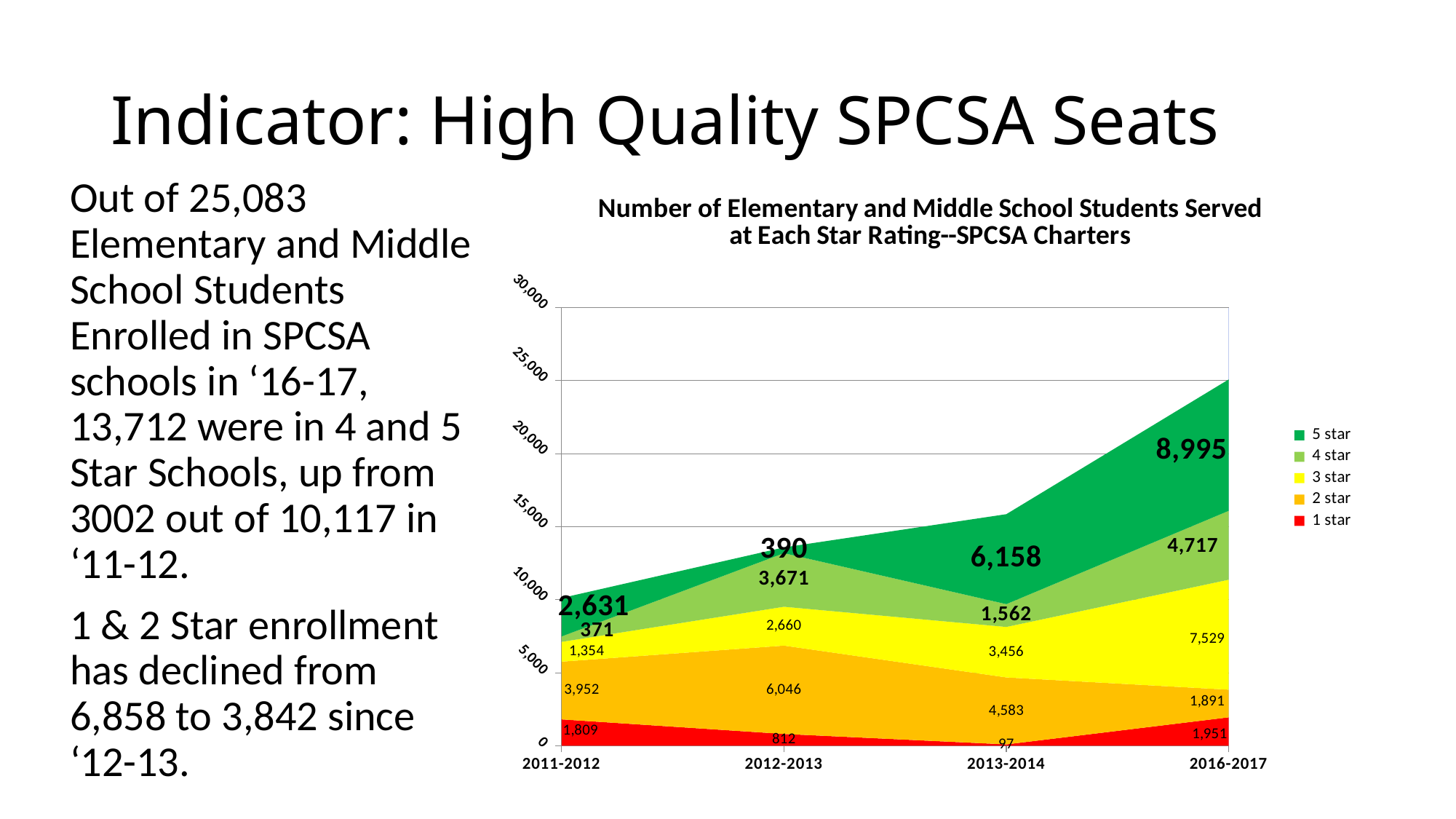
In which school year was the 5 star value highest? 2016-2017 What is the total number of students served across all star ratings in 2016-2017? 25,083 How many school years are shown on the x axis? 4 How many 1 star students were served in 2013-2014? 97 How many 2 star students were served in 2012-2013? 6,046 Which is larger in 2012-2013: the 4 star value or the 5 star value? 4 star What is the difference between the 5 star values for 2016-2017 and 2013-2014? 2,837 How many 5 star students were served in 2016-2017? 8,995 Does the 3 star value rise or fall across the school years from 2011-2012 to 2016-2017? Rise How many series does the legend list? 5 What type of chart is shown on the slide? Stacked area chart In which school year was the 1 star value lowest? 2013-2014